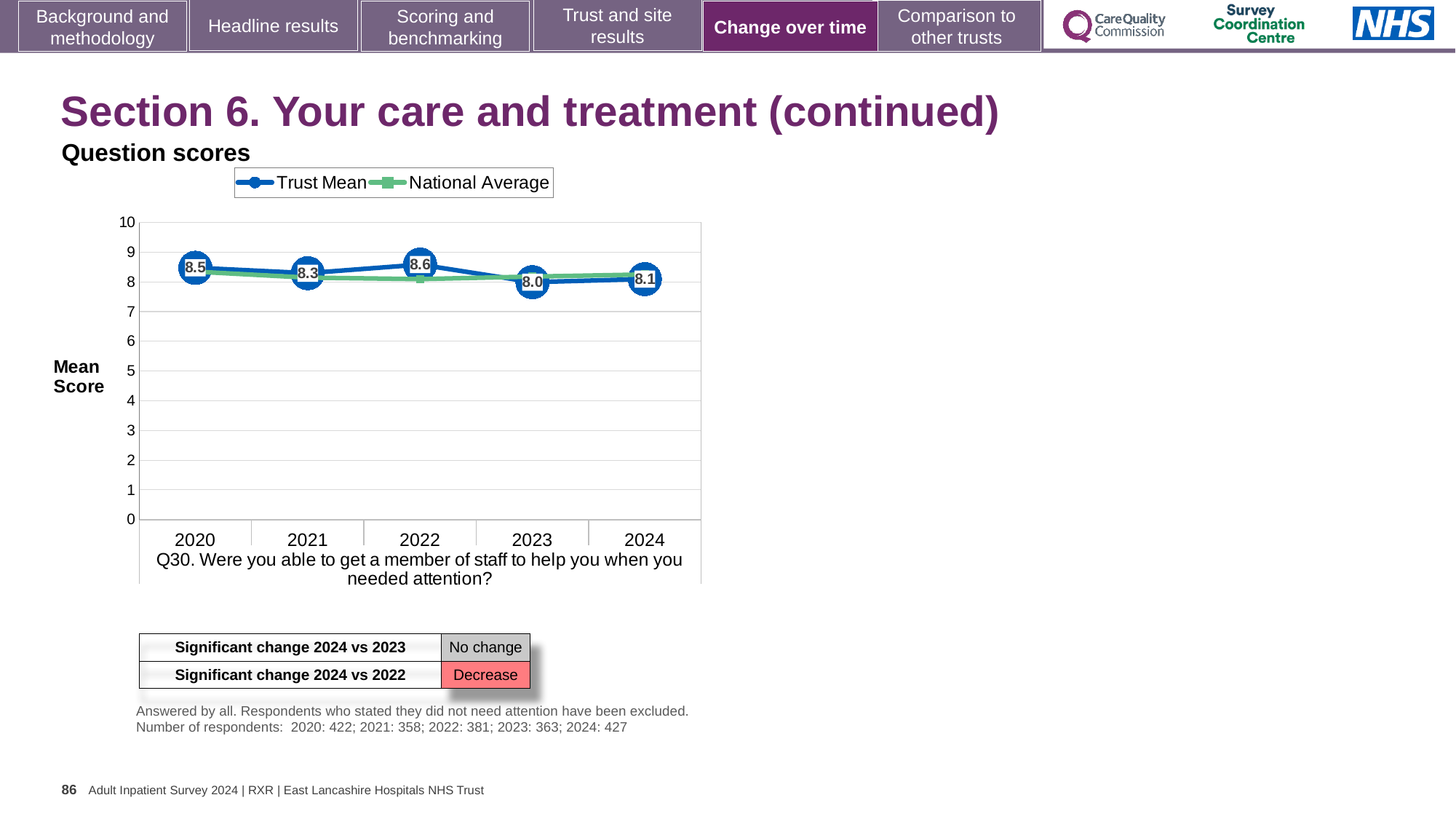
What kind of chart is shown on the slide? Line chart What is the Trust Mean score for 2024? 8.1 How many series does the chart legend list? 2 Which year has the larger Trust Mean score, 2021 or 2023? 2021 Is the Trust Mean score for 2023 greater or less than 9? less What is the difference between the Trust Mean scores for 2022 and 2023? 0.6 How many years are shown on the x axis of the chart? 5 What is the label of the y axis of the chart? Mean Score In which year is the Trust Mean score highest? 2022 What is the Trust Mean score for 2020? 8.5 What is the Trust Mean score for 2022? 8.6 In which year is the Trust Mean score lowest? 2023